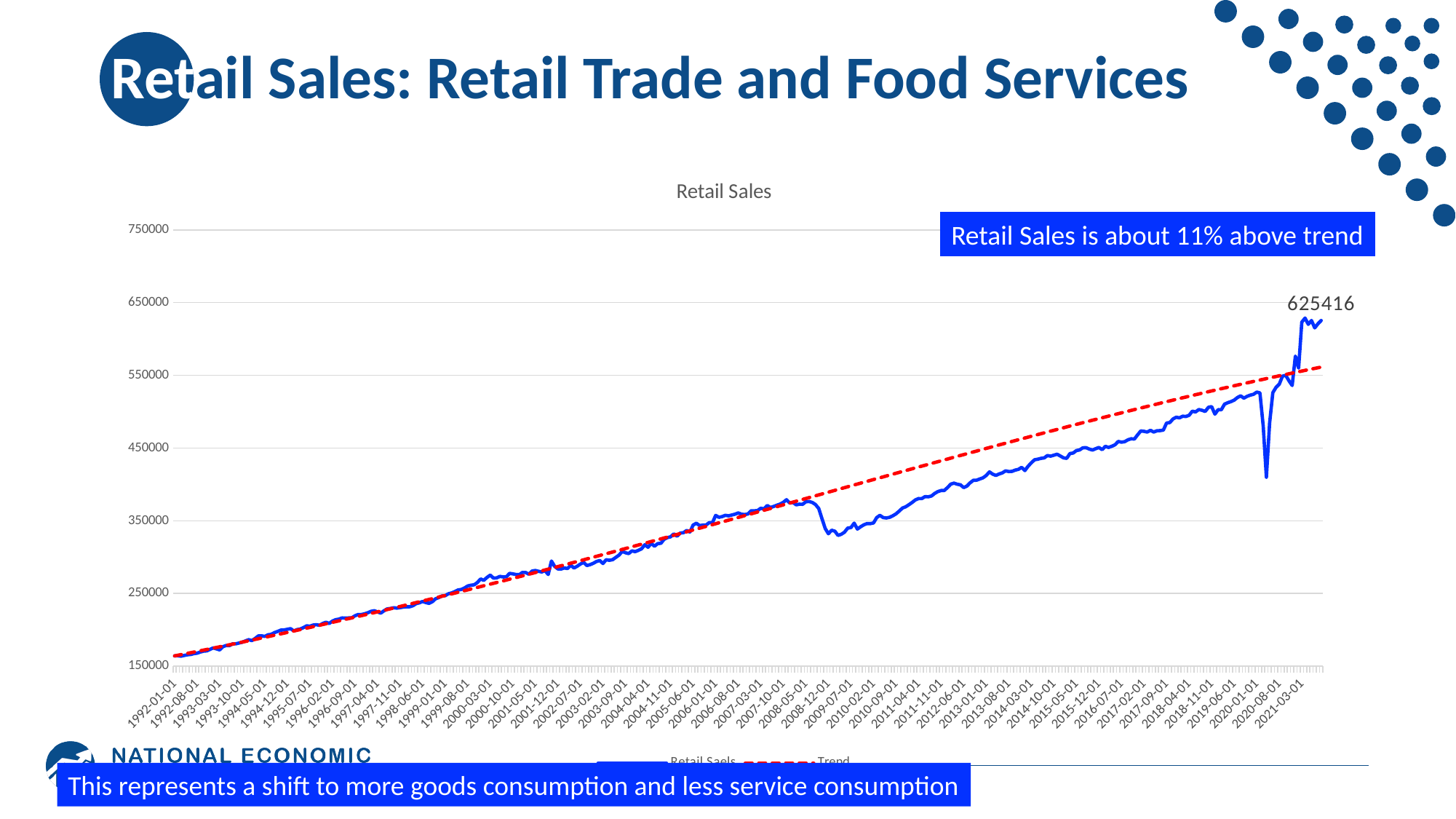
Is the Retail Sales value at 2021-03-01 greater or less than 550000? greater Do the Retail Sales values generally rise or fall from 1992 to 2021? rise At the right end of the chart, which series is higher: Retail Sales or Trend? Retail Sales What is the title of the chart? Retail Sales What kind of chart is shown on the slide? line chart What is the highest value labelled on the y axis? 750000 Is the lowest point of the sharp dip in Retail Sales during 2020 greater or less than 450000? less According to the annotation on the slide, by about what percentage is Retail Sales above trend? about 11% Is the Retail Sales value at 1992-01-01 greater or less than 250000? less How many series does the chart's legend list? 2 Around 2009-07-01, is the Retail Sales line above or below the Trend line? below What is the value shown by the data label at the end of the Retail Sales line? 625416